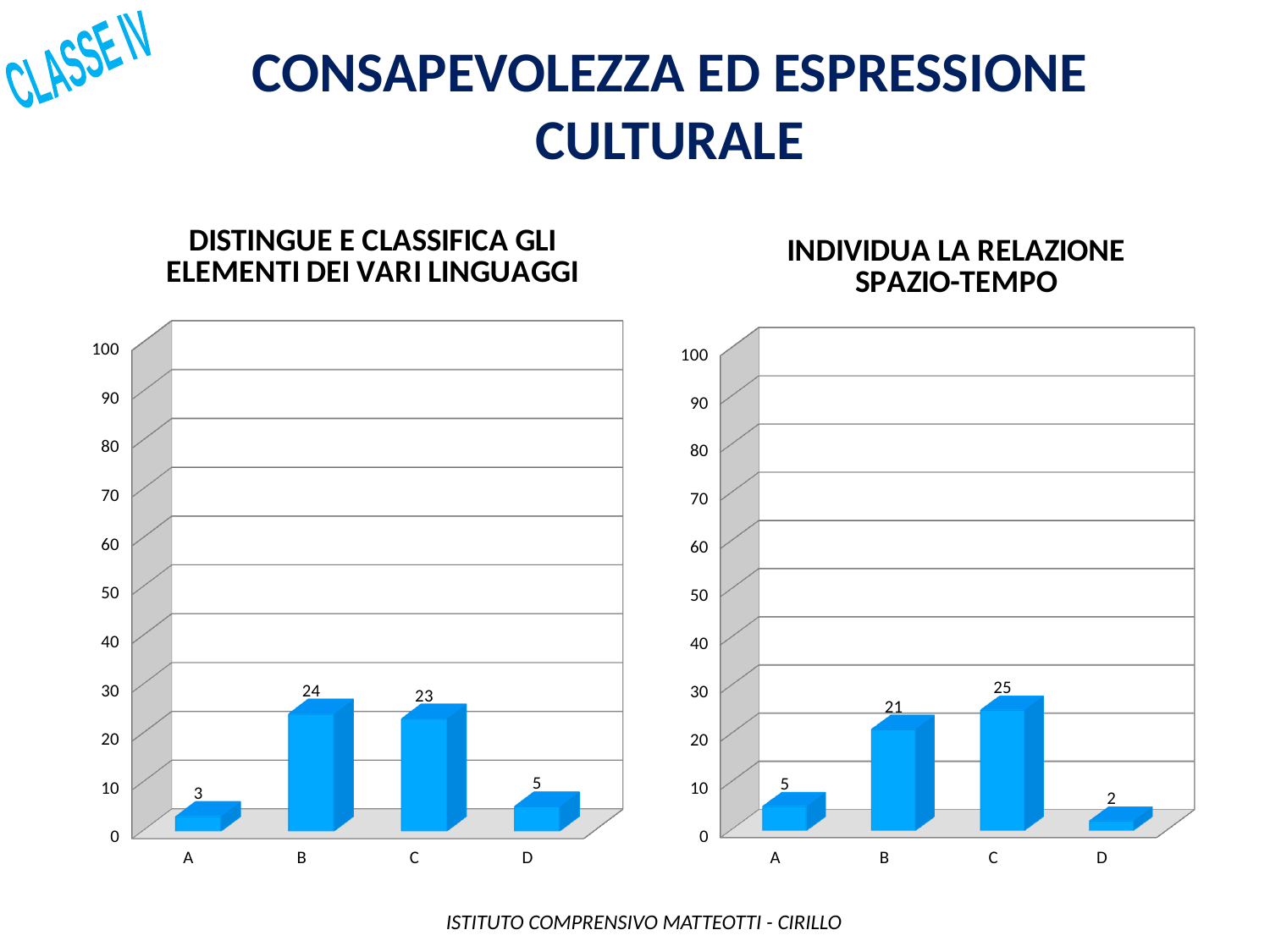
In the chart titled 'INDIVIDUA LA RELAZIONE SPAZIO-TEMPO', which category has the lowest value? D What kind of chart is the chart titled 'DISTINGUE E CLASSIFICA GLI ELEMENTI DEI VARI LINGUAGGI'? bar chart In the chart titled 'DISTINGUE E CLASSIFICA GLI ELEMENTI DEI VARI LINGUAGGI', what is the value for category A? 3 In the chart titled 'DISTINGUE E CLASSIFICA GLI ELEMENTI DEI VARI LINGUAGGI', is the value for C greater or less than 30? less In the chart titled 'DISTINGUE E CLASSIFICA GLI ELEMENTI DEI VARI LINGUAGGI', what is the difference between the values for D and A? 2 In the chart titled 'INDIVIDUA LA RELAZIONE SPAZIO-TEMPO', what is the value for category D? 2 How many categories are shown in the chart titled 'INDIVIDUA LA RELAZIONE SPAZIO-TEMPO'? 4 In the chart titled 'INDIVIDUA LA RELAZIONE SPAZIO-TEMPO', what is the value for category C? 25 In the chart titled 'INDIVIDUA LA RELAZIONE SPAZIO-TEMPO', which is larger, the value for A or the value for D? A In the chart titled 'INDIVIDUA LA RELAZIONE SPAZIO-TEMPO', what is the difference between the values for C and B? 4 In the chart titled 'DISTINGUE E CLASSIFICA GLI ELEMENTI DEI VARI LINGUAGGI', which category has the highest value? B In the chart titled 'DISTINGUE E CLASSIFICA GLI ELEMENTI DEI VARI LINGUAGGI', what is the value for category B? 24